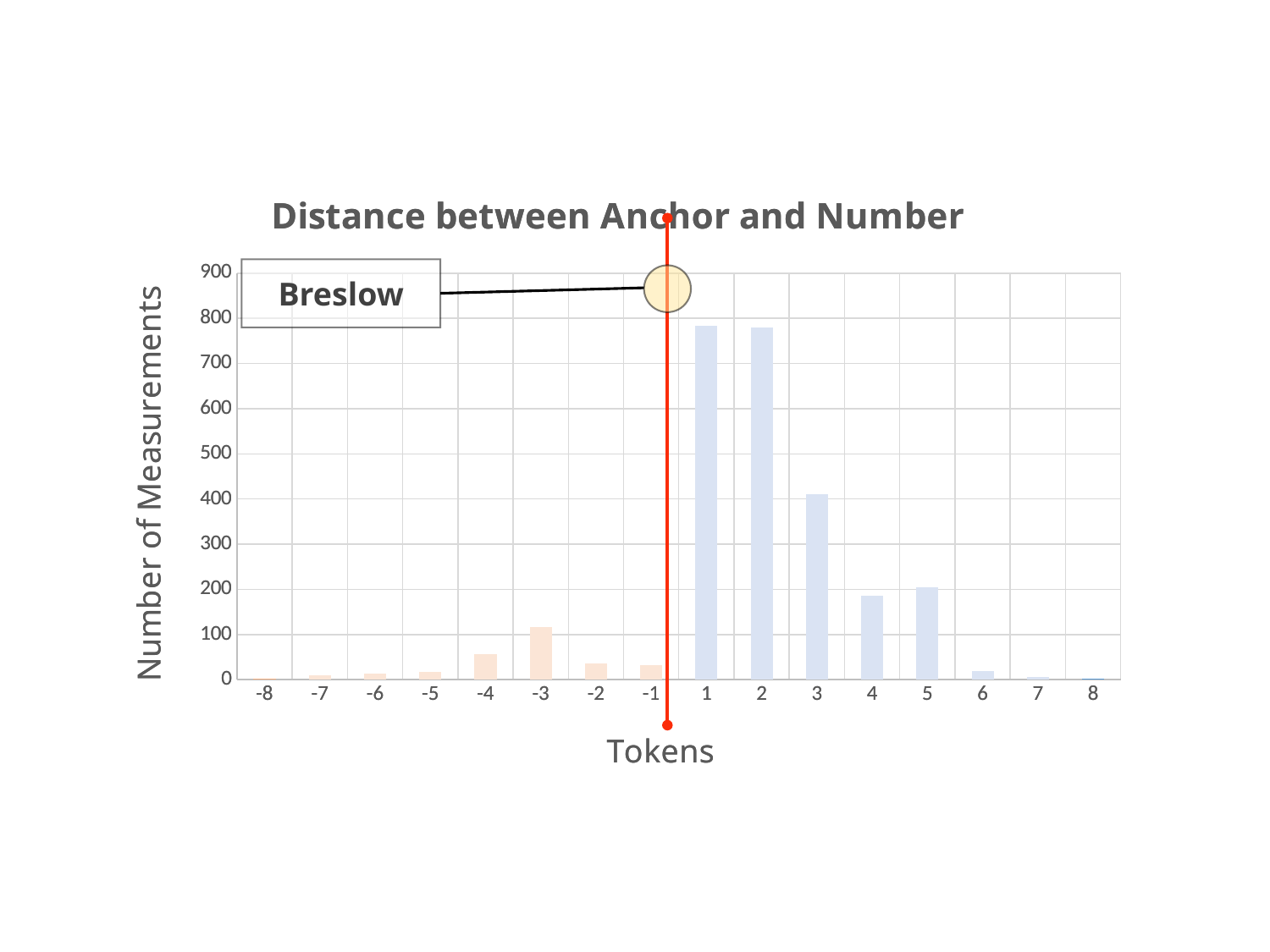
Which has a larger value, token 3 or token 4? 3 What kind of chart is shown on the slide? bar chart Is the value for token -3 greater or less than 100? greater Is the value for token 1 greater or less than 700? greater What is the title of the chart? Distance between Anchor and Number What is the label of the vertical axis? Number of Measurements Which has a larger value, token -3 or token -4? -3 How many token categories are shown on the x axis? 16 Is the value for token 4 greater or less than 200? less Do the values rise or fall as the tokens go from 2 to 8? fall